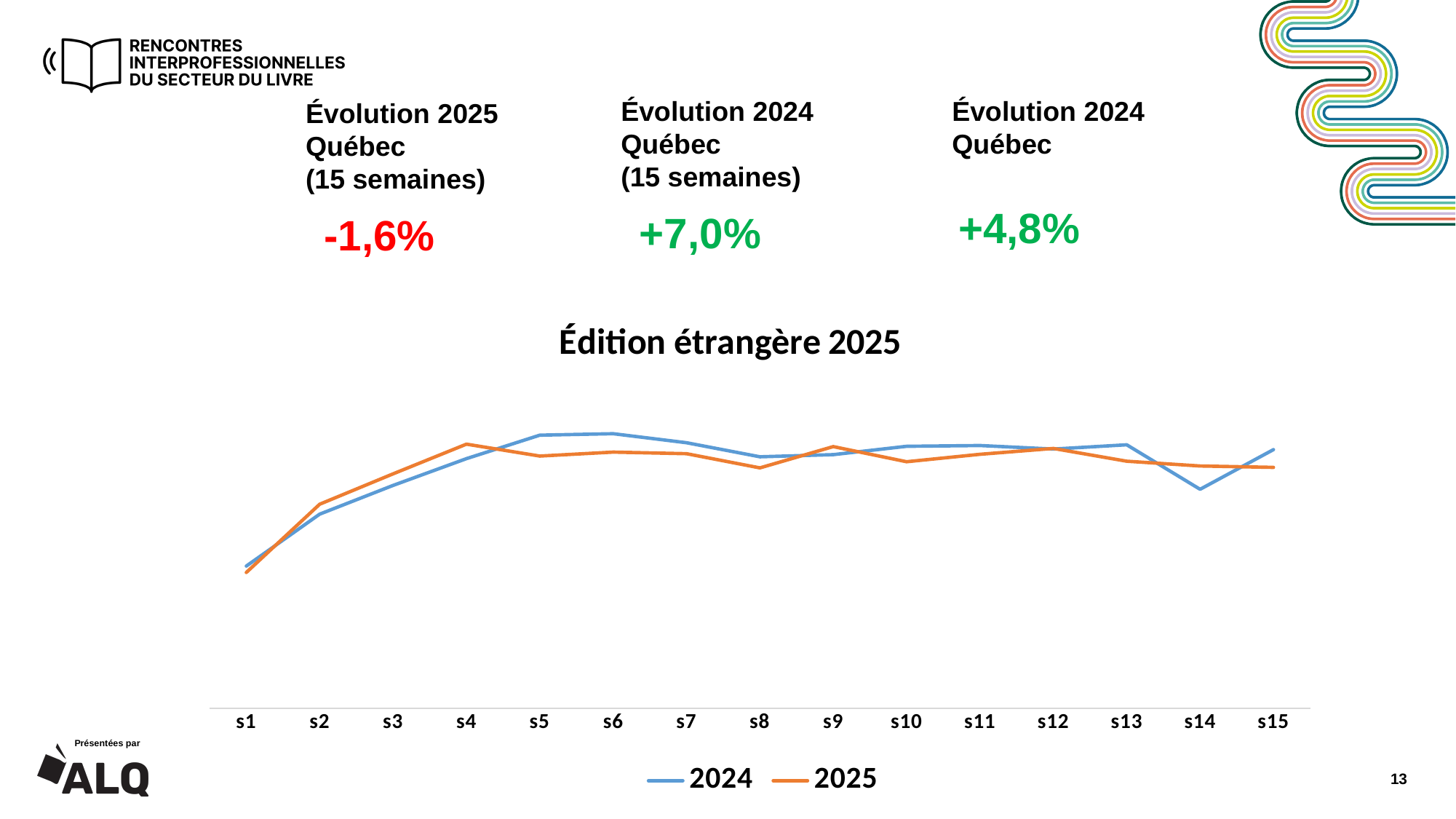
At week s15, which series has the higher value, 2024 or 2025? 2024 What kind of chart is shown on the slide? line chart Which colour represents the 2025 series in the chart? orange How many weeks (points) are plotted along the x axis of the chart? 15 At which week is the 2025 series at its lowest value? s1 At week s14, which series has the higher value, 2024 or 2025? 2025 At week s5, which series has the higher value, 2024 or 2025? 2024 At which week is the 2024 series at its lowest value? s1 What is the title of the chart? Édition étrangère 2025 Do the values of the 2025 series rise or fall from s1 to s4? rise How many series does the chart legend list? 2